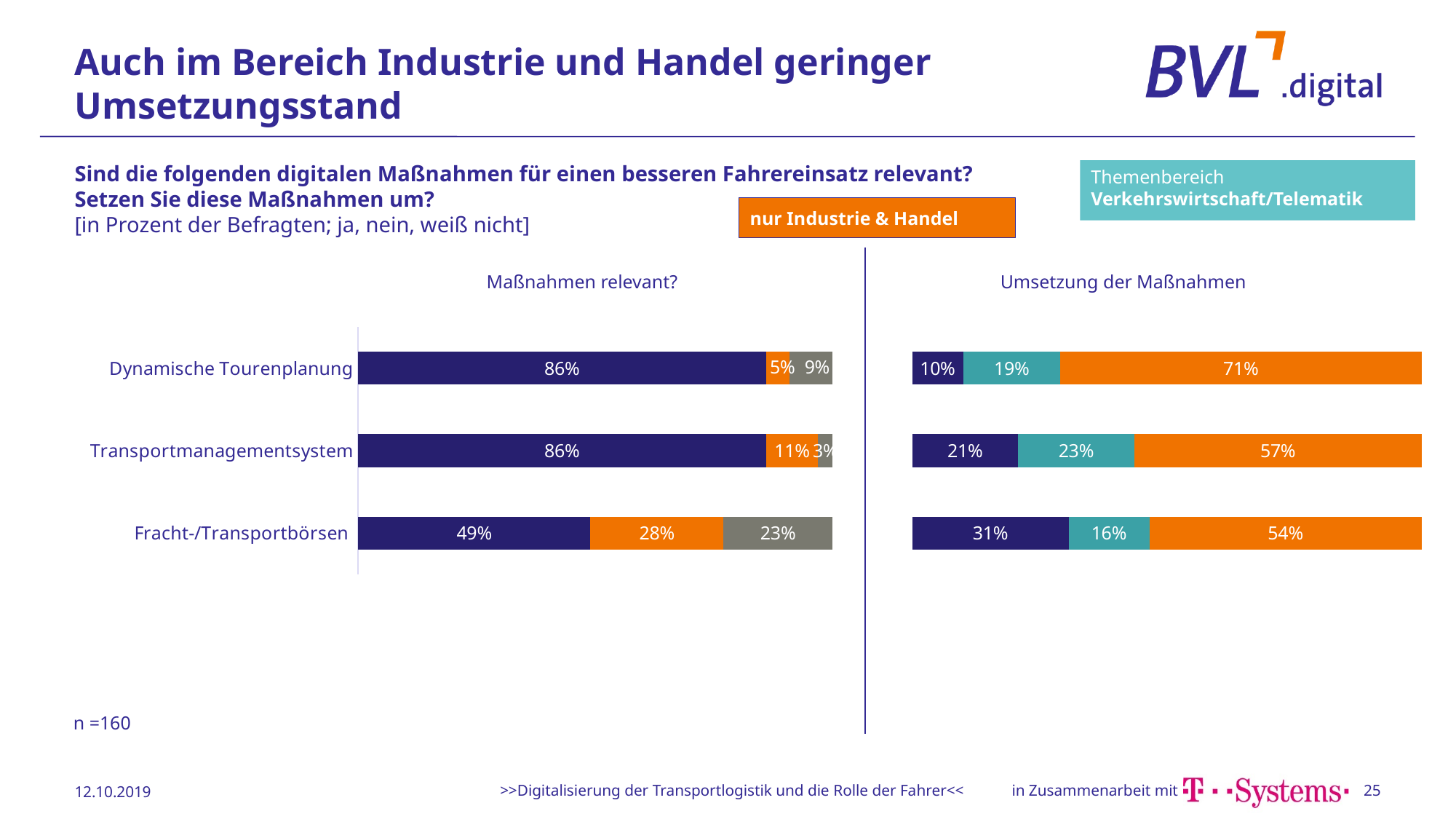
What type of chart is the 'Maßnahmen relevant?' chart? Stacked bar chart In the 'Umsetzung der Maßnahmen' chart, which category has the highest value in the dark blue segment? Fracht-/Transportbörsen In the 'Umsetzung der Maßnahmen' chart, what is the value of the teal segment for Transportmanagementsystem? 23% What sample size (n) is stated on the slide? n =160 In the 'Maßnahmen relevant?' chart, what is the value of the orange segment for Fracht-/Transportbörsen? 28% In the 'Maßnahmen relevant?' chart, which category has the lowest value in the dark blue segment? Fracht-/Transportbörsen How many categories are shown in the 'Umsetzung der Maßnahmen' chart? 3 In the 'Umsetzung der Maßnahmen' chart, what is the difference between the orange segment values for Dynamische Tourenplanung and Fracht-/Transportbörsen? 17 percentage points In the 'Maßnahmen relevant?' chart, what is the value of the dark blue segment for Dynamische Tourenplanung? 86% In the 'Umsetzung der Maßnahmen' chart, what is the total of the three segments for Transportmanagementsystem? 101% In the 'Maßnahmen relevant?' chart, which is larger: the grey segment for Dynamische Tourenplanung or the grey segment for Fracht-/Transportbörsen? Fracht-/Transportbörsen In the 'Umsetzung der Maßnahmen' chart, what is the value of the orange segment for Dynamische Tourenplanung? 71%